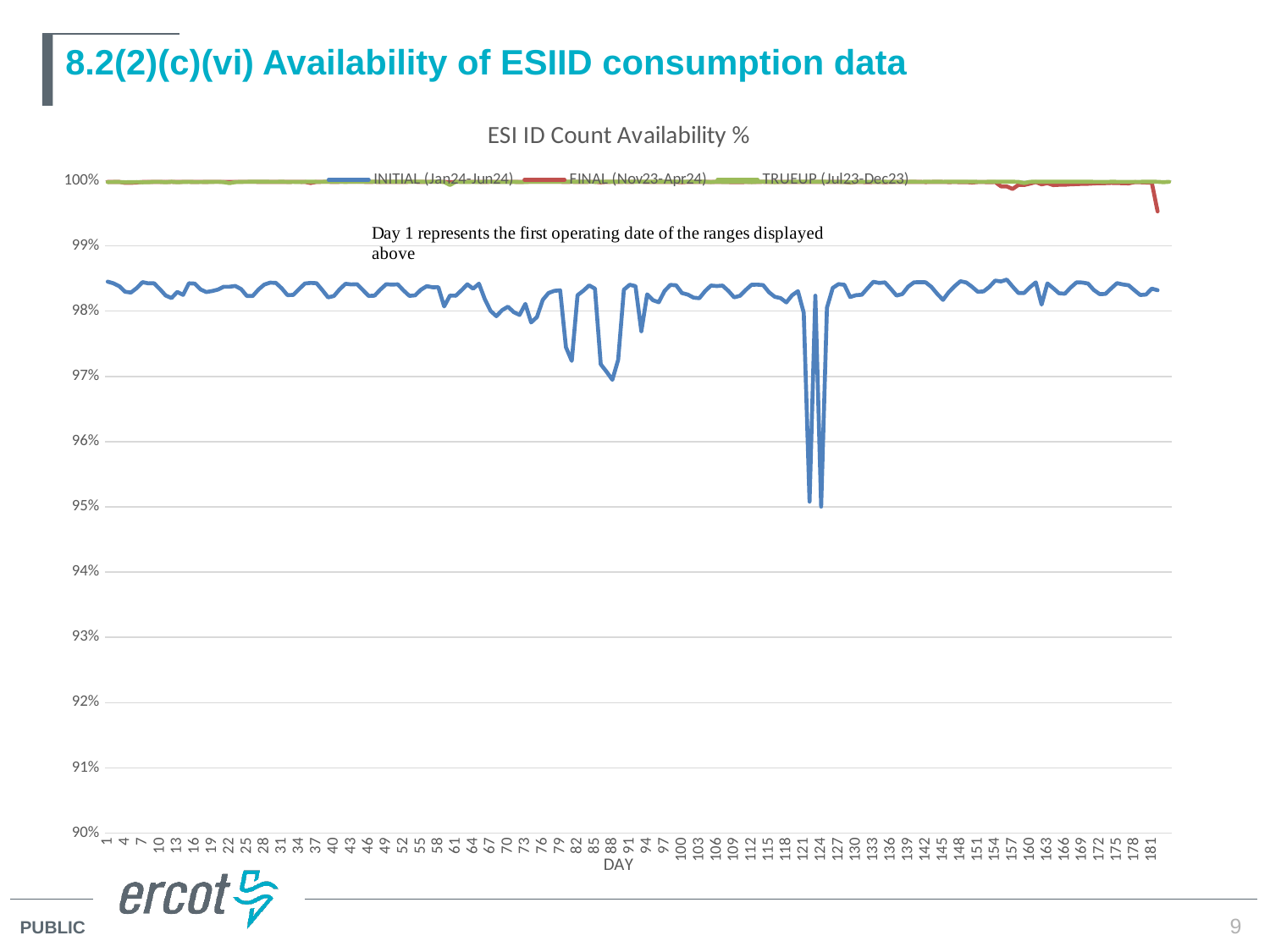
Is the value of the INITIAL (Jan24-Jun24) series at day 88 greater or less than 98%? less What kind of chart is shown on the slide? line chart How many series does the legend list? 3 What is the last day label shown on the x axis? 181 Is the lowest value of the INITIAL (Jan24-Jun24) series, around day 121, greater or less than 96%? less What is the label of the x axis? DAY Is the value of the TRUEUP (Jul23-Dec23) series at day 1 greater or less than 99%? greater At day 1, which series is higher: INITIAL (Jan24-Jun24) or TRUEUP (Jul23-Dec23)? TRUEUP (Jul23-Dec23) What is the title of the chart? ESI ID Count Availability % Which series reaches the lowest value anywhere on the chart? INITIAL (Jan24-Jun24)